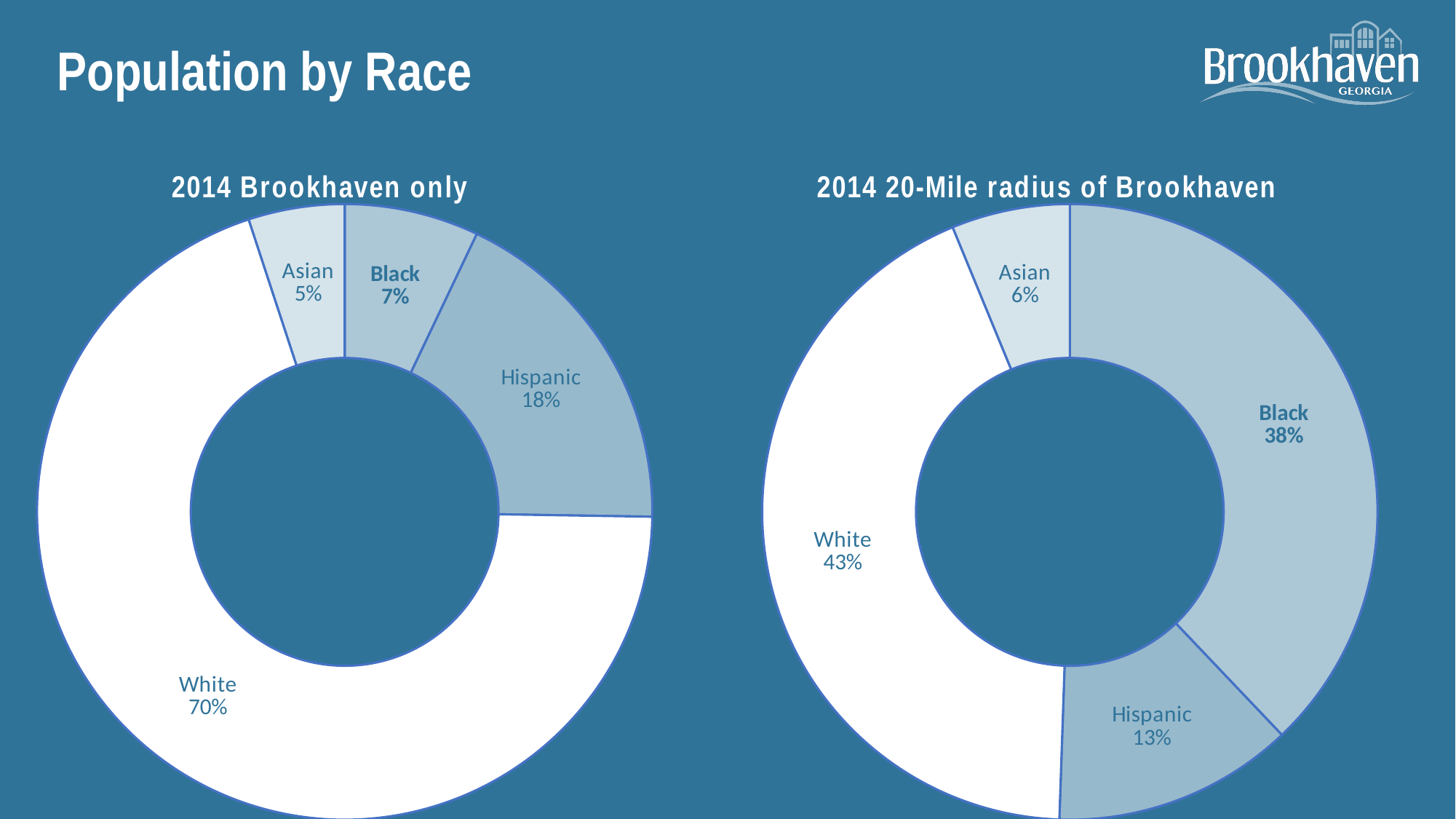
In the '2014 Brookhaven only' chart, what share of the population is White? 70% In the '2014 20-Mile radius of Brookhaven' chart, what share of the population is Black? 38% What is the title of the chart on the left side of the slide? 2014 Brookhaven only What kind of chart is the '2014 20-Mile radius of Brookhaven' chart? Doughnut (pie) chart In the '2014 Brookhaven only' chart, which is larger, the Hispanic share or the Black share? Hispanic In the '2014 20-Mile radius of Brookhaven' chart, which race has the largest share? White How many categories are shown in the '2014 Brookhaven only' chart? 4 In the '2014 20-Mile radius of Brookhaven' chart, what share of the population is Asian? 6% In the '2014 Brookhaven only' chart, which race has the smallest share? Asian What is the difference between the Black share in the '2014 20-Mile radius of Brookhaven' chart and the Black share in the '2014 Brookhaven only' chart? 31% In the '2014 Brookhaven only' chart, what share of the population is Hispanic? 18% In the '2014 20-Mile radius of Brookhaven' chart, which race has the smallest share? Asian